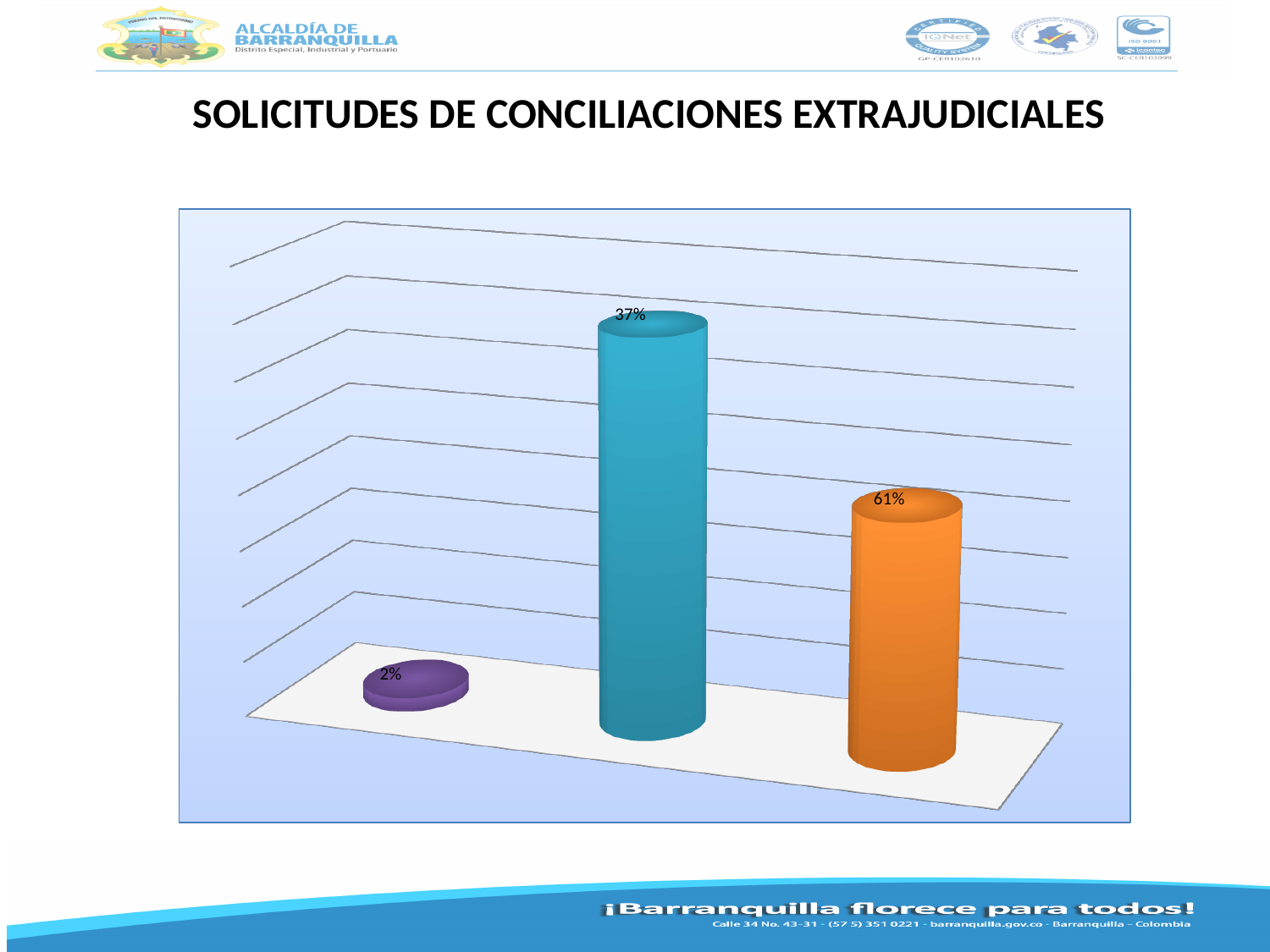
Which labelled value is larger, the orange bar's or the teal bar's? the orange bar's (61%) What value is labelled on the orange bar? 61% What is the title of the slide above the chart? SOLICITUDES DE CONCILIACIONES EXTRAJUDICIALES What is the difference between the labelled values of the teal bar and the purple bar? 35 percentage points What value is labelled on the teal (blue) bar? 37% What type of chart is shown on the slide? bar chart Which bar carries the largest labelled value? the orange bar (61%) How many bars are plotted in the chart? 3 What do the three labelled values on the bars add up to? 100% What value is labelled on the purple bar? 2% What is the difference between the labelled values of the orange bar and the teal bar? 24 percentage points Which bar carries the smallest labelled value? the purple bar (2%)